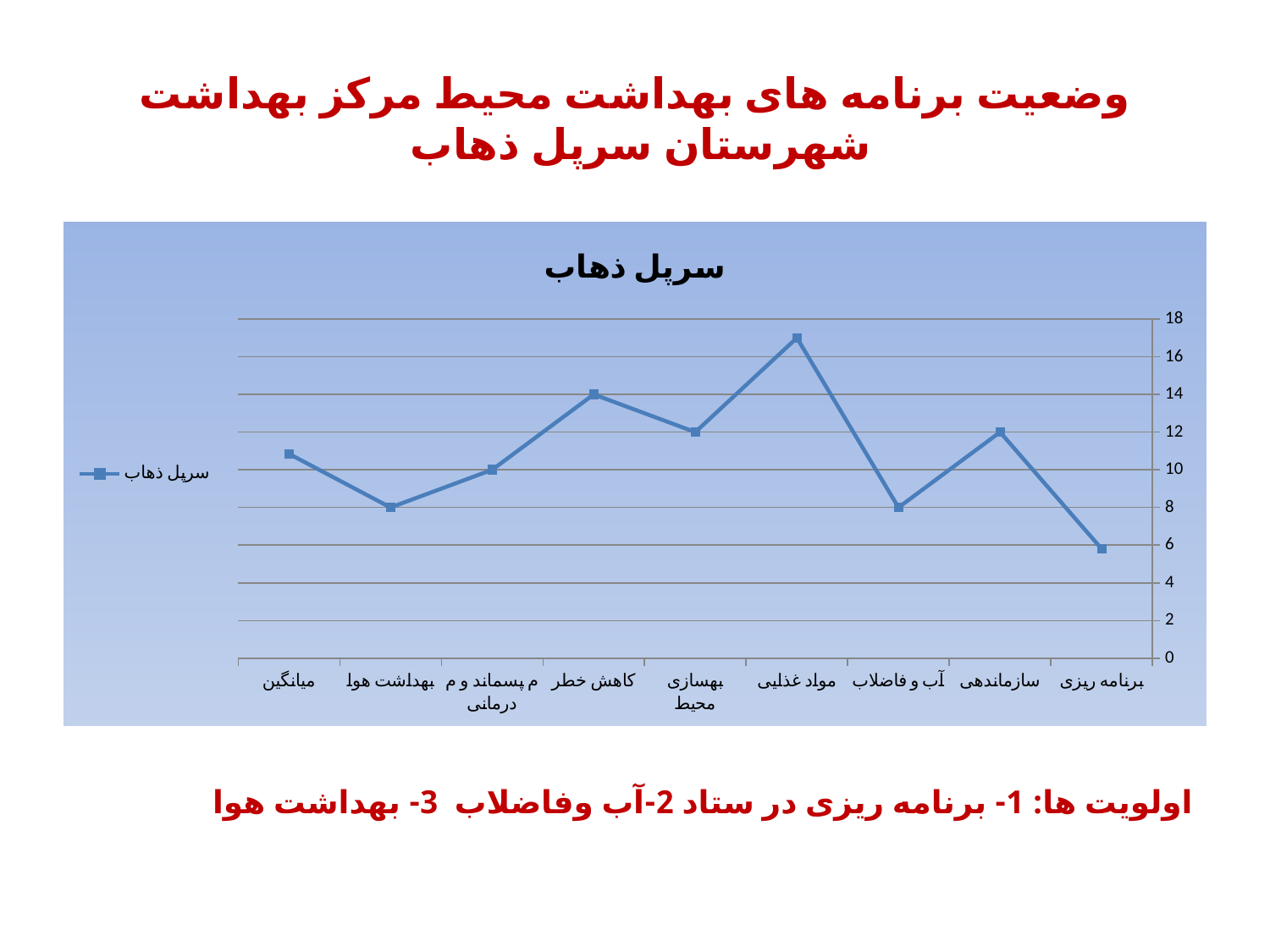
What is the value for آب و فاضلاب? 8 Which category has the highest value in the chart? مواد غذایی How many categories are plotted along the x axis of the chart? 9 What is the value for کاهش خطر? 14 How many series does the chart's legend list? 1 What is the title of the chart? سرپل ذهاب What is the difference between the values for کاهش خطر and م پسماند و م درمانی? 4 Which has the larger value, سازماندهی or آب و فاضلاب? سازماندهی Which category has the lowest value in the chart? برنامه ریزی What kind of chart is shown on the slide? line chart Is the value for برنامه ریزی greater or less than 8? less Is the value for مواد غذایی greater or less than 16? greater